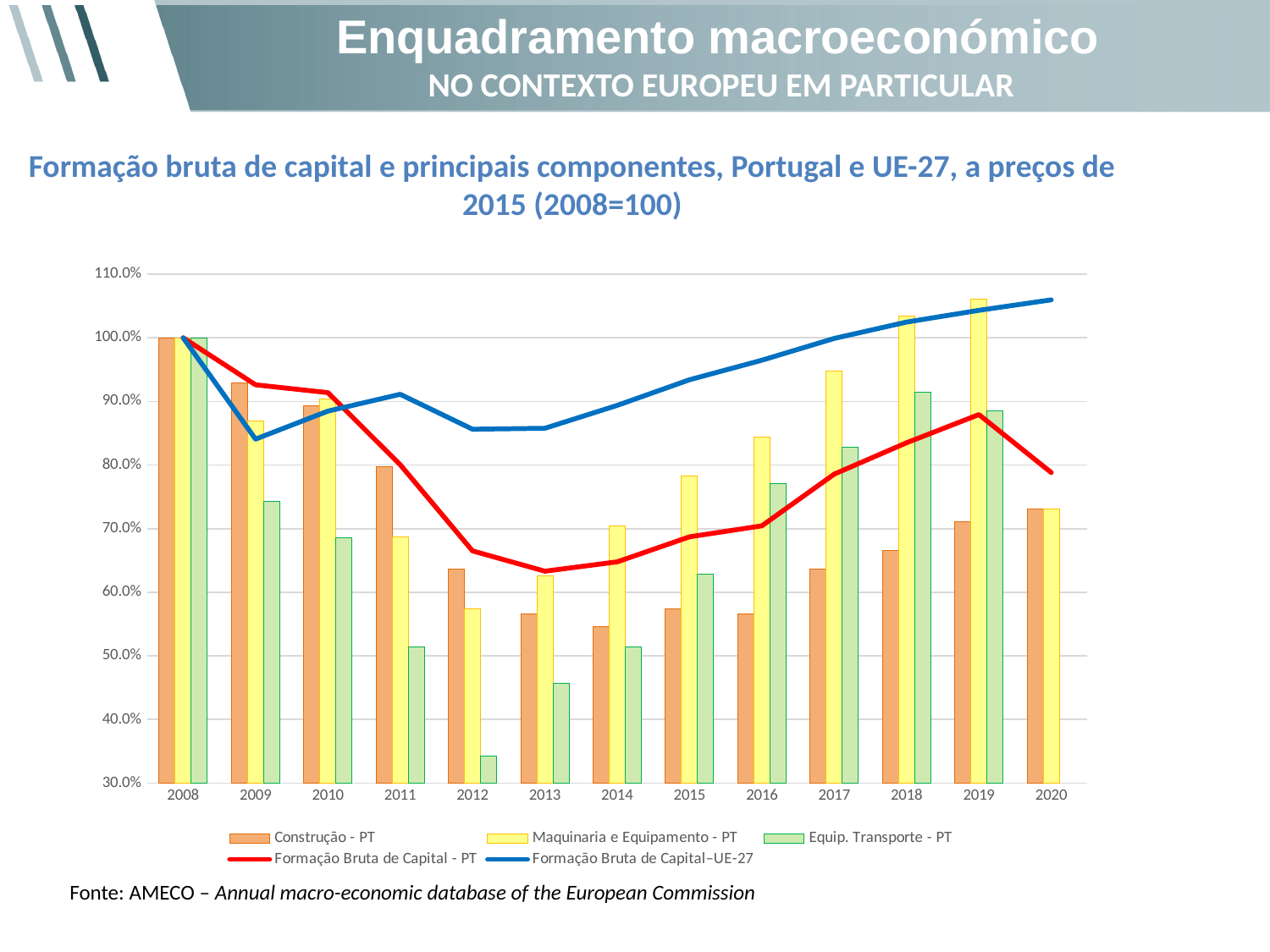
What is the value of Formação Bruta de Capital–UE-27 in 2008? 100.0% How many series does the legend list? 5 In which year is Equip. Transporte - PT at its lowest? 2012 Is the value for Formação Bruta de Capital - PT in 2013 greater or less than 70.0%? less Does the Formação Bruta de Capital–UE-27 line rise or fall from 2013 to 2020? Rise How many years are shown on the x axis? 13 In 2016, which is larger: Maquinaria e Equipamento - PT or Equip. Transporte - PT? Maquinaria e Equipamento - PT Is the value for Equip. Transporte - PT in 2013 greater or less than 40.0%? greater What is the value of Construção - PT in 2008? 100.0% What kind of chart is shown on the slide? A combined bar and line chart Is the value for Maquinaria e Equipamento - PT in 2019 greater or less than 100.0%? greater In which year is Maquinaria e Equipamento - PT at its highest? 2019